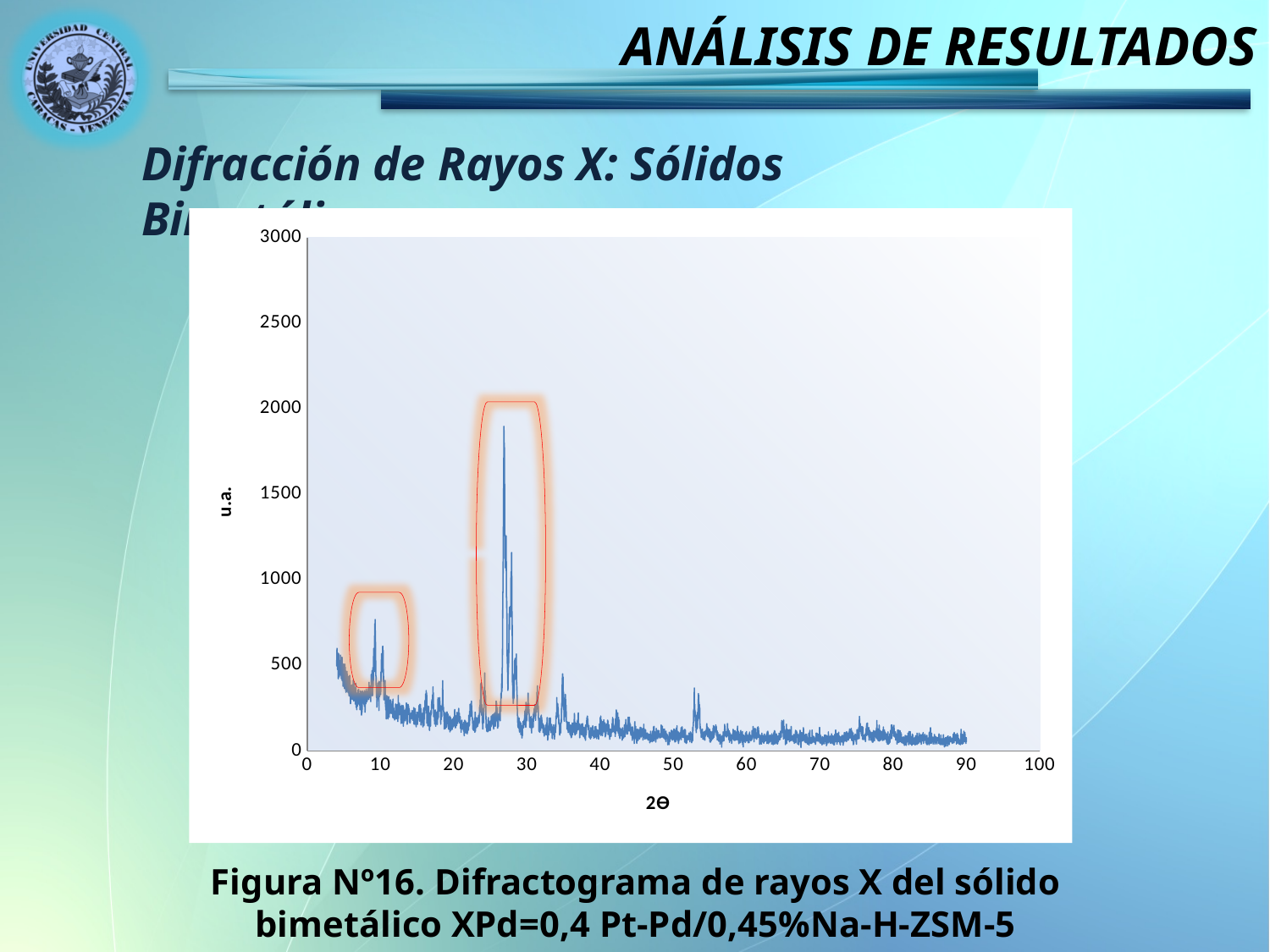
Is the peak near 2Θ = 9 greater or less than 500? greater What is the label of the y axis of the chart? u.a. Overall, does the intensity rise or fall as 2Θ increases from 0 to 90? fall Is the signal at 2Θ = 80 greater or less than 500? less Is the tallest peak of the diffractogram (near 2Θ = 27) greater or less than 2500? less In which 2Θ range does the highest peak of the diffractogram occur: between 20 and 30, or between 50 and 60? between 20 and 30 What kind of chart is shown on the slide? line chart Which is larger: the peak near 2Θ = 27 or the peak near 2Θ = 9? the peak near 2Θ = 27 What is the maximum value shown on the y axis of the chart? 3000 What is the label of the x axis of the chart? 2Θ